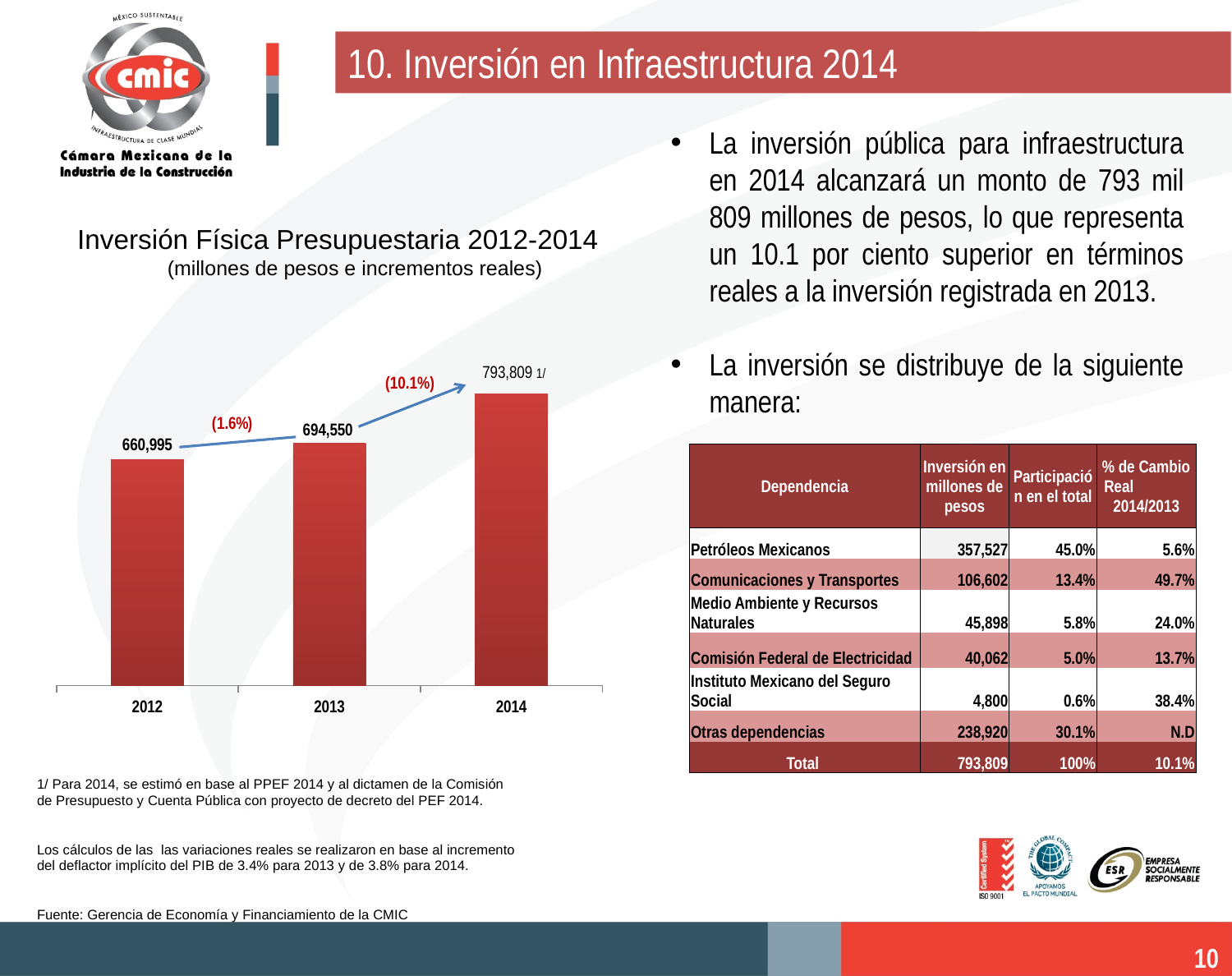
What percentage increase is annotated between the 2013 and 2014 bars in the chart? (10.1%) Do the values in the chart rise or fall from 2012 to 2014? Rise How many years (bars) are shown in the chart? 3 What kind of chart is shown on the slide? Bar chart What is the value shown for 2012 in the chart? 660,995 What is the value shown for 2014 in the chart? 793,809 What is the difference between the 2013 value and the 2012 value in the chart? 33,555 Which year has the highest value in the chart? 2014 Which year has the lowest value in the chart? 2012 What is the value shown for 2013 in the chart? 694,550 Which is larger in the chart, the value for 2013 or the value for 2012? 2013 What is the difference between the 2014 value and the 2013 value in the chart? 99,259